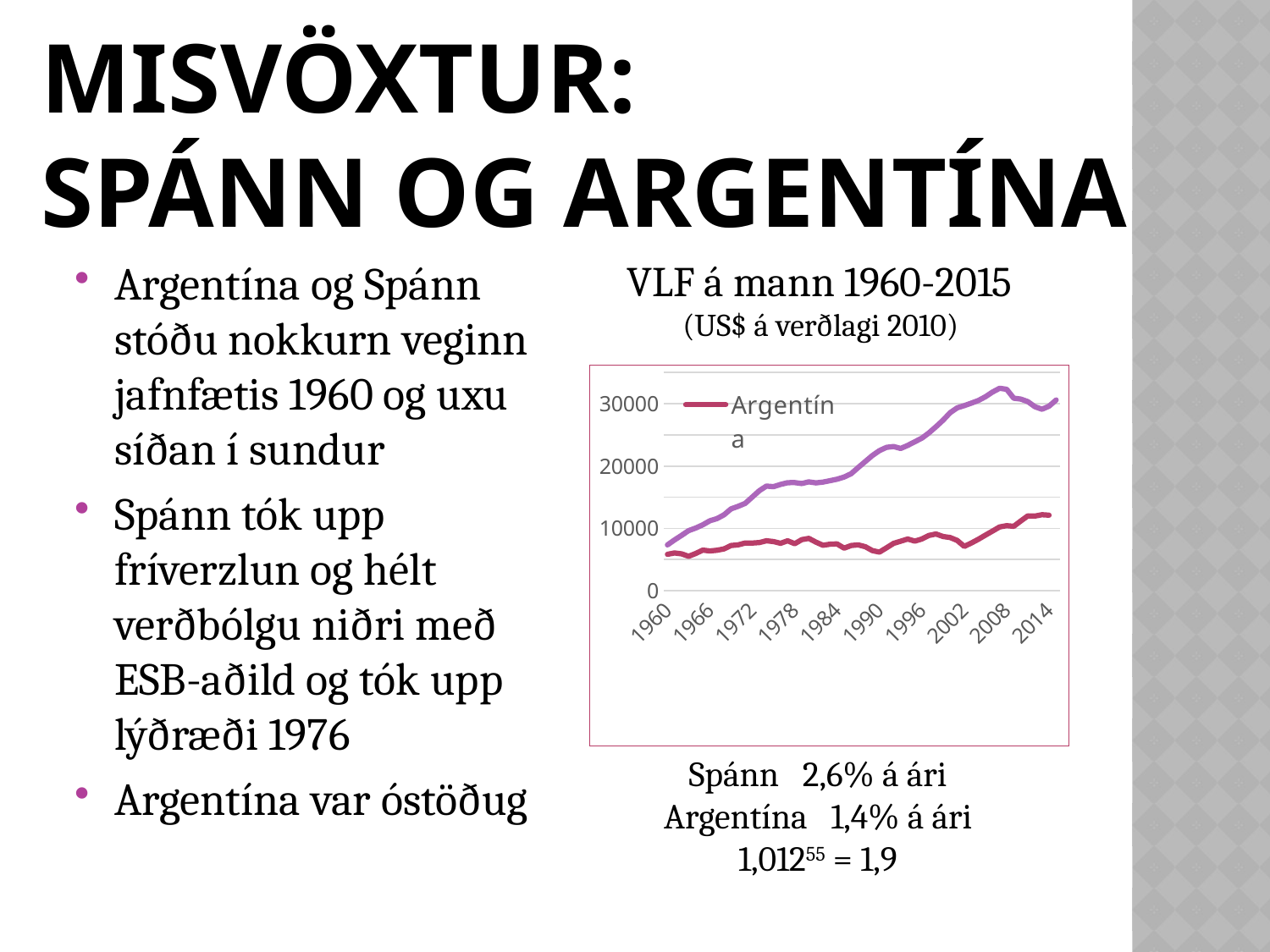
In 2014, which line is higher: the purple line or the Argentína line? the purple line Does the purple line generally rise or fall from 1960 to 2014? rise Which series is named in the chart's legend? Argentína What is the highest tick value shown on the y axis? 30000 Is the value for Argentína in 2014 greater or less than 10000? greater Is the value of the purple line in 1990 greater or less than 20000? greater Is the value of the purple line in 1960 greater or less than 10000? less What is the title of the chart? VLF á mann 1960-2015 (US$ á verðlagi 2010) How many year labels are shown on the x axis of the chart? 10 How many lines are plotted on the chart? 2 What kind of chart is shown on the slide? line chart